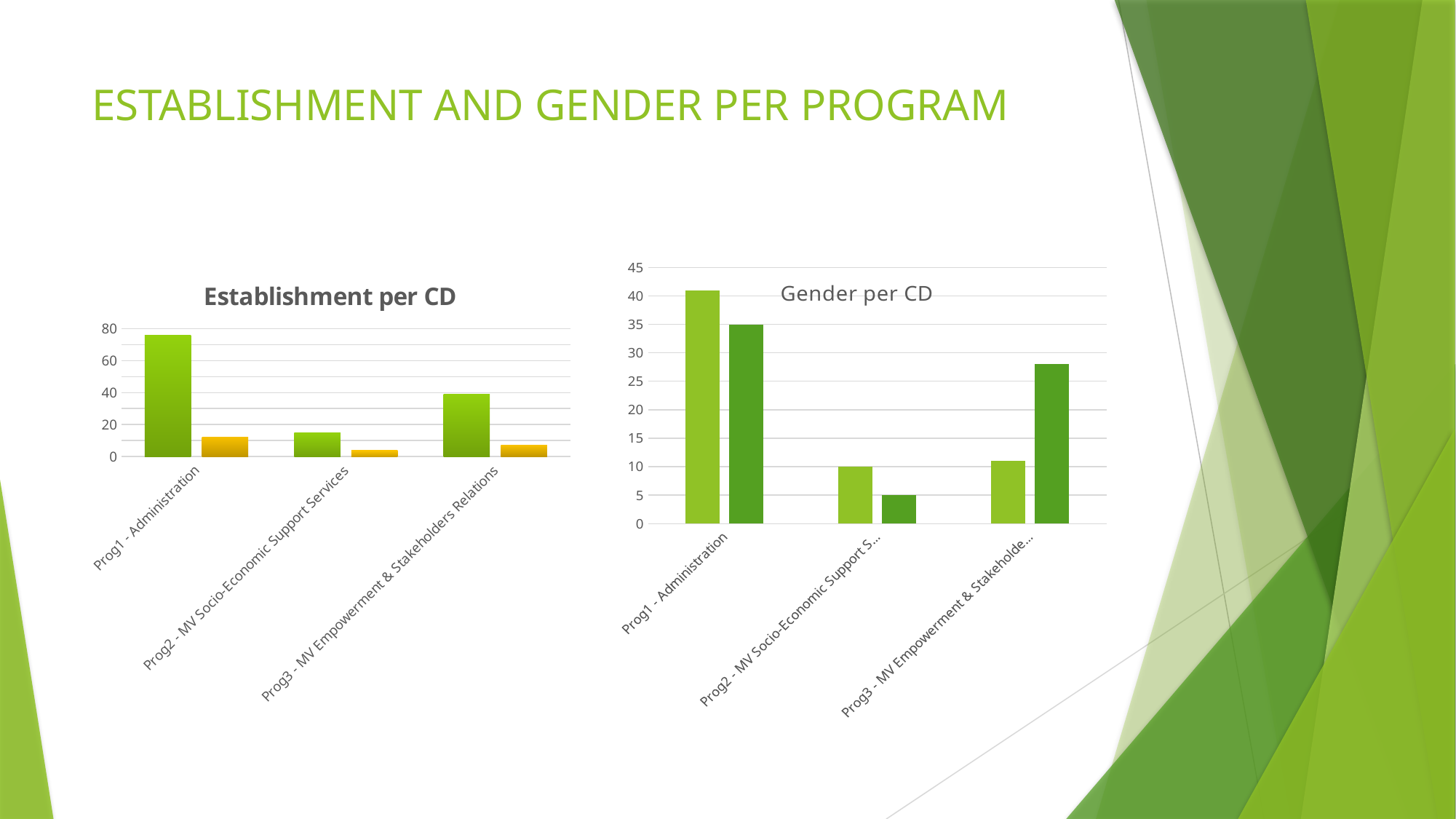
In the 'Establishment per CD' chart, is the orange bar for Prog2 - MV Socio-Economic Support Services greater or less than 20? less How many program categories are shown on the x axis of the 'Establishment per CD' chart? 3 In the 'Gender per CD' chart, what is the value of the light green bar for Prog2 - MV Socio-Economic Support S...? 10 In the 'Gender per CD' chart, what is the value of the dark green bar for Prog2 - MV Socio-Economic Support S...? 5 In the 'Establishment per CD' chart, which program has the tallest green bar? Prog1 - Administration In the 'Establishment per CD' chart, which program has the shortest green bar? Prog2 - MV Socio-Economic Support Services What type of chart is the 'Establishment per CD' chart? bar chart What is the title of the chart on the right side of the slide? Gender per CD In the 'Establishment per CD' chart, is the green bar for Prog1 - Administration greater or less than 60? greater In the 'Gender per CD' chart, which bar is larger for Prog3 - MV Empowerment & Stakeholde..., the light green or the dark green bar? dark green